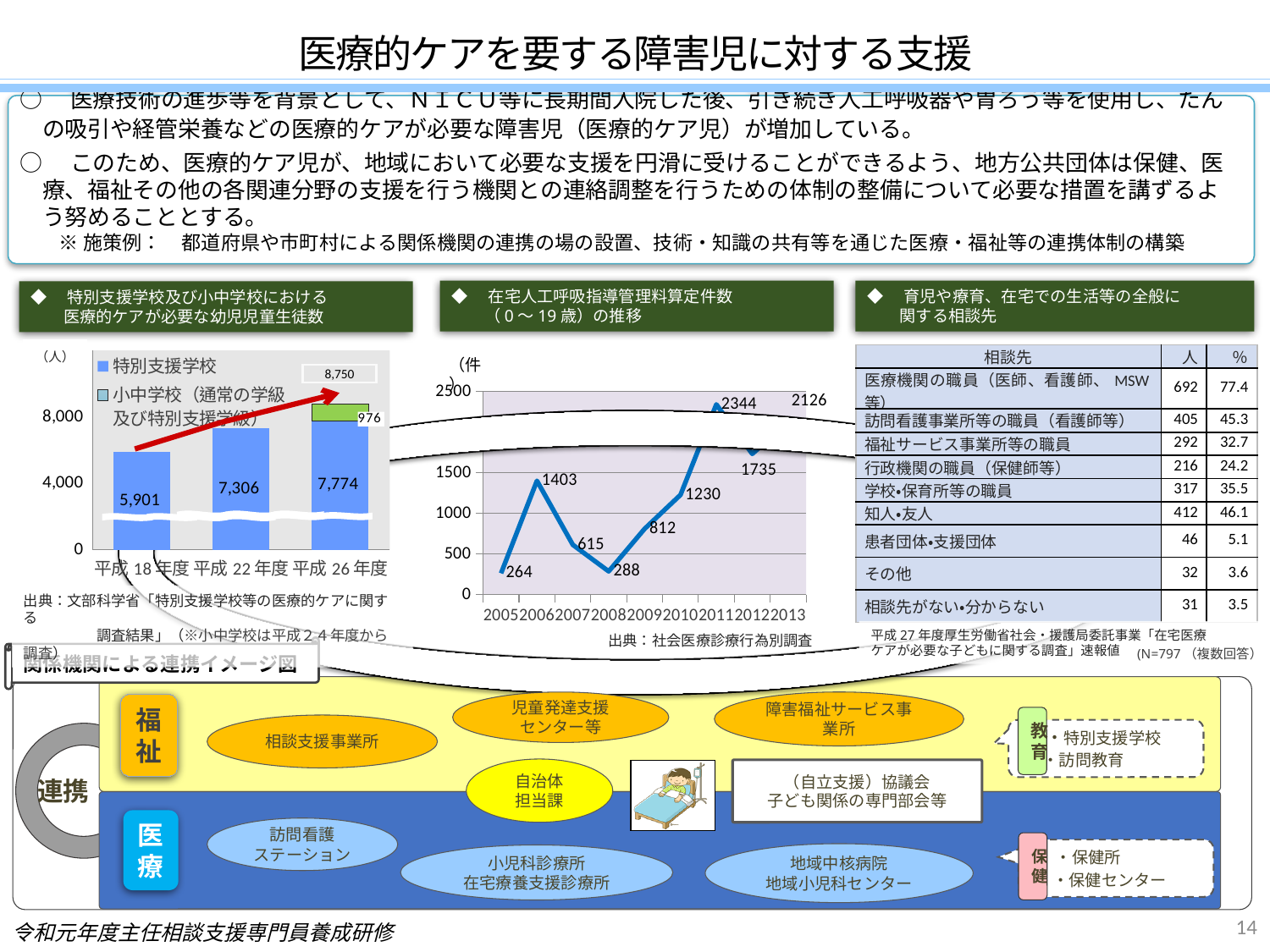
In the bar chart on the left, what is the value for 小中学校 in 平成26年度? 976 In the bar chart on the left, what is the total of the stacked bar for 平成26年度? 8,750 In the middle line chart, which year has the lowest value? 2005 In the bar chart on the left, what is the value for 特別支援学校 in 平成18年度? 5,901 In the bar chart on the left, how many series does the legend list? 2 In the middle line chart, how many data points are plotted? 9 In the bar chart on the left, what is the difference between the 特別支援学校 values for 平成22年度 and 平成18年度? 1,405 In the middle line chart, which year has the highest value? 2011 In the middle line chart, what is the value for 2009? 812 In the bar chart on the left, what is the value for 特別支援学校 in 平成26年度? 7,774 What kind of chart is the middle chart showing 在宅人工呼吸指導管理料算定件数? line chart In the bar chart on the left, do the 特別支援学校 values rise or fall from 平成18年度 to 平成26年度? rise